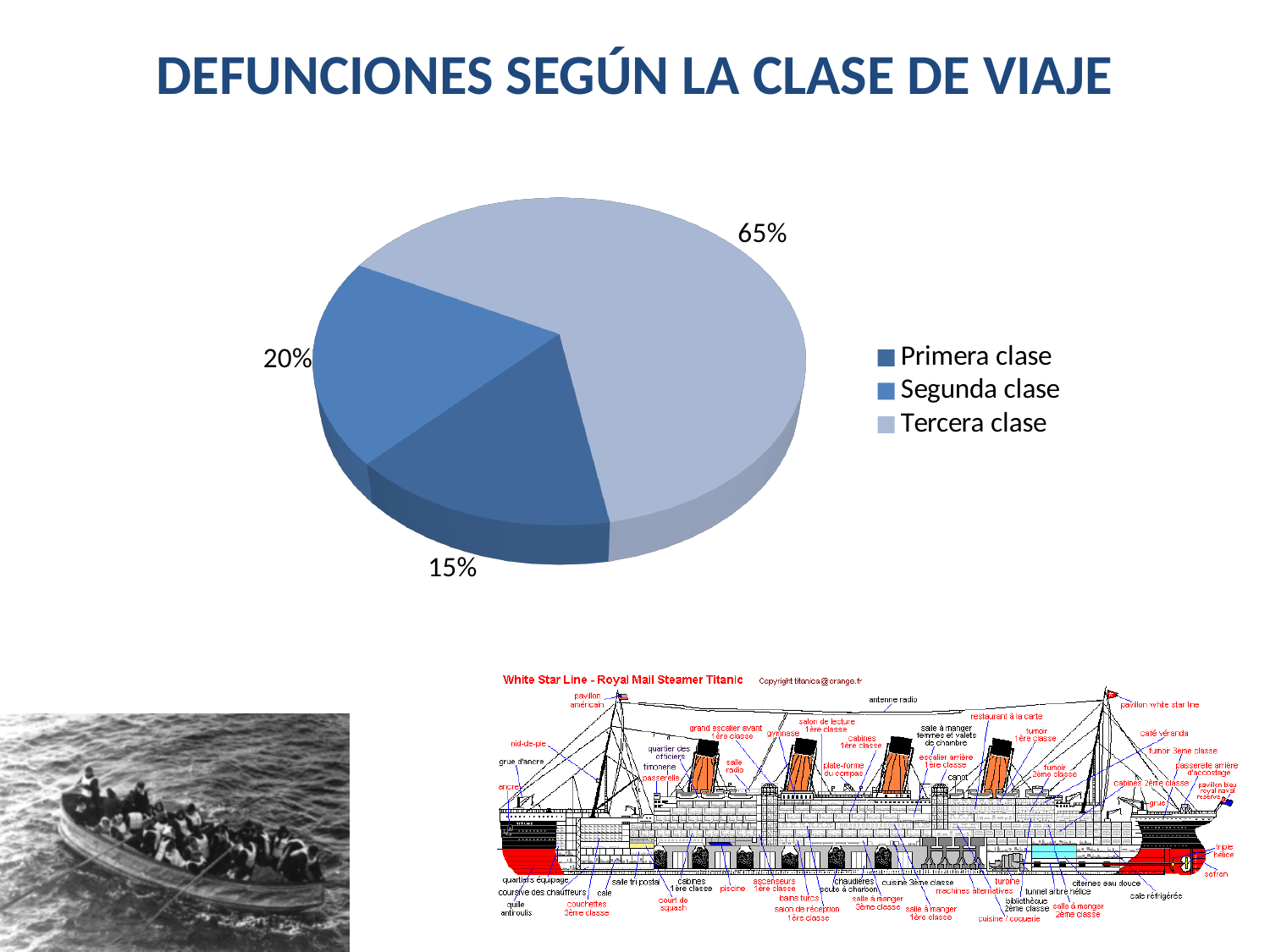
Which class has the smallest share of the pie? Primera clase Which class has the largest share of the pie? Tercera clase Which is larger, the share for Segunda clase or the share for Primera clase? Segunda clase What is the difference in percentage points between Segunda clase and Primera clase? 5 What kind of chart is shown on the slide? Pie chart What is the difference in percentage points between Tercera clase and Segunda clase? 45 What percentage of the pie corresponds to Segunda clase? 20% What is the title of the slide containing the pie chart? DEFUNCIONES SEGÚN LA CLASE DE VIAJE How many entries does the legend list? 3 What percentage of the pie corresponds to Tercera clase? 65% How many slices does the pie chart have? 3 What percentage of the pie corresponds to Primera clase? 15%